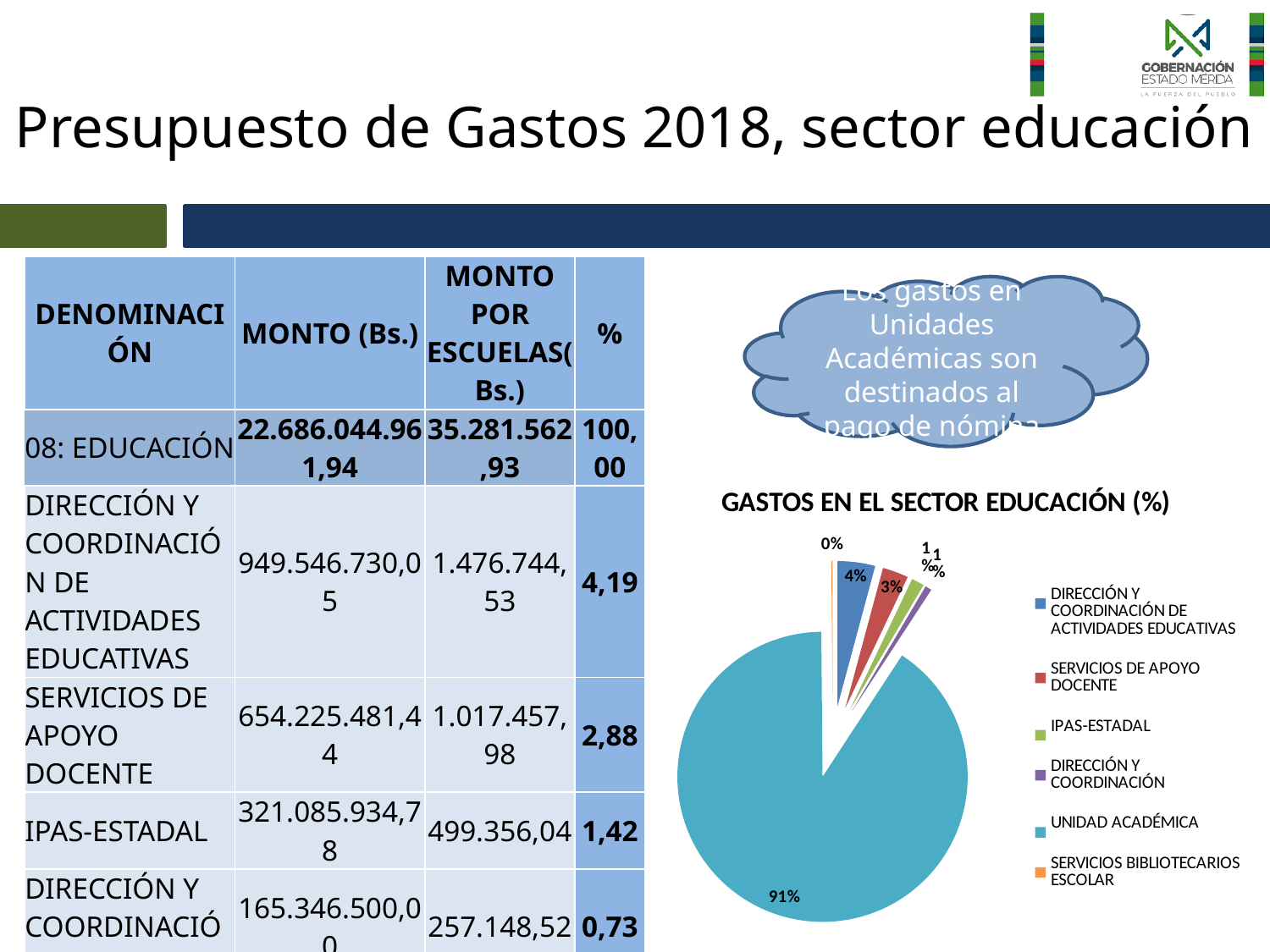
What kind of chart is shown under the title "GASTOS EN EL SECTOR EDUCACIÓN (%)"? Pie chart Which category has the smallest slice in the pie chart? SERVICIOS BIBLIOTECARIOS ESCOLAR How many slices does the pie chart have? 6 In the pie chart, what is the difference in percentage points between DIRECCIÓN Y COORDINACIÓN DE ACTIVIDADES EDUCATIVAS (4%) and SERVICIOS DE APOYO DOCENTE (3%)? 1 percentage point In the pie chart, which is larger: DIRECCIÓN Y COORDINACIÓN DE ACTIVIDADES EDUCATIVAS or SERVICIOS DE APOYO DOCENTE? DIRECCIÓN Y COORDINACIÓN DE ACTIVIDADES EDUCATIVAS What is the title of the pie chart on the slide? GASTOS EN EL SECTOR EDUCACIÓN (%) What percentage does the pie chart show for SERVICIOS BIBLIOTECARIOS ESCOLAR? 0% Which category has the largest slice in the pie chart? UNIDAD ACADÉMICA What percentage does the pie chart show for DIRECCIÓN Y COORDINACIÓN DE ACTIVIDADES EDUCATIVAS? 4% What percentage does the pie chart show for SERVICIOS DE APOYO DOCENTE? 3% What percentage does the pie chart show for UNIDAD ACADÉMICA? 91% How many entries does the legend of the pie chart list? 6